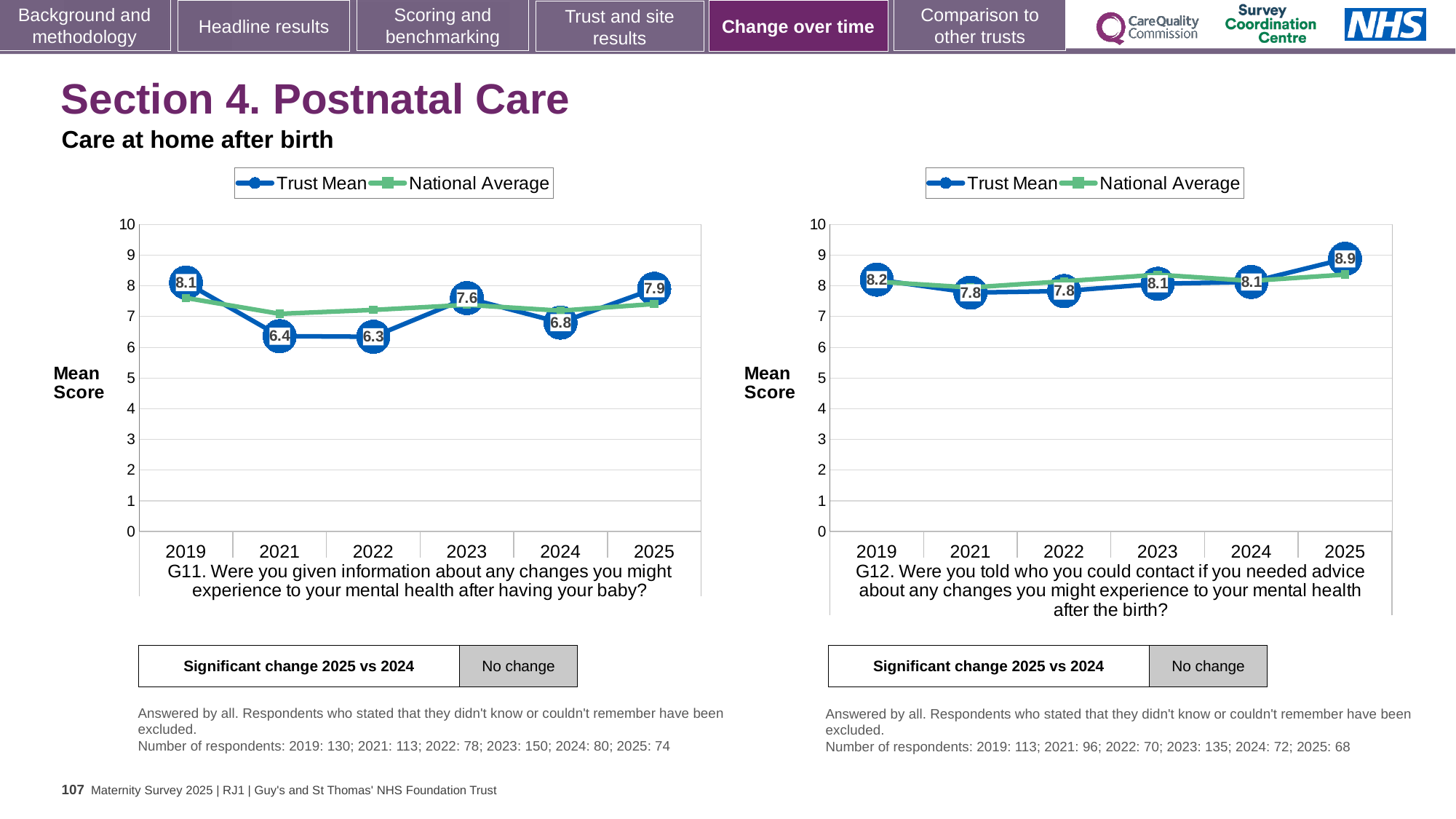
In the right chart (G12), what is the Trust Mean score for 2025? 8.9 In the right chart (G12), which year has the highest Trust Mean score? 2025 In the left chart (G11), which year has the highest Trust Mean score? 2019 In the right chart (G12), what is the difference between the Trust Mean scores for 2025 and 2019? 0.7 In the left chart (G11), what is the difference between the Trust Mean scores for 2025 and 2024? 1.1 In the left chart (G11), what is the Trust Mean score for 2022? 6.3 In the left chart (G11), which year has the lowest Trust Mean score? 2022 How many years are plotted on the x axis of the left chart (G11)? 6 How many series does the legend of the right chart (G12) list? 2 In the left chart (G11), is the National Average for 2021 greater or less than 8? less In the right chart (G12), is the Trust Mean score for 2025 larger than the Trust Mean score for 2021? Yes In the left chart (G11), what is the Trust Mean score for 2019? 8.1